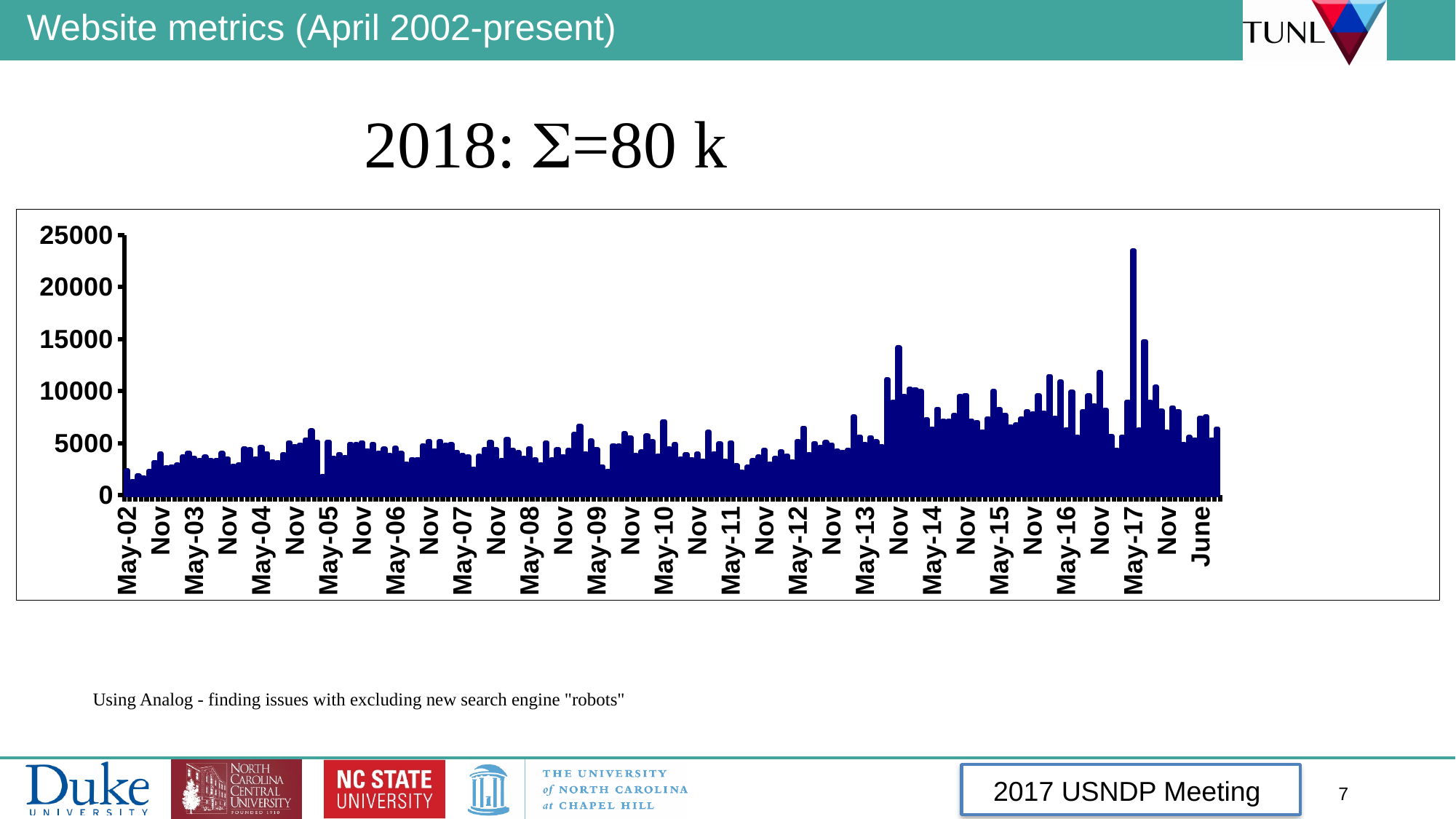
What is the first label on the x axis? May-02 Is the tallest bar in the chart greater or less than 20000? greater Is the value for May-02 greater or less than 5000? less Is the value for the last bar (June) greater or less than 10000? less What is the highest tick value shown on the y axis? 25000 In which year does the tallest bar of the chart occur? 2017 Do the values generally rise or fall from May-02 to May-17? rise What kind of chart is shown on the slide? bar chart Which has the larger value, May-02 or May-17? May-17